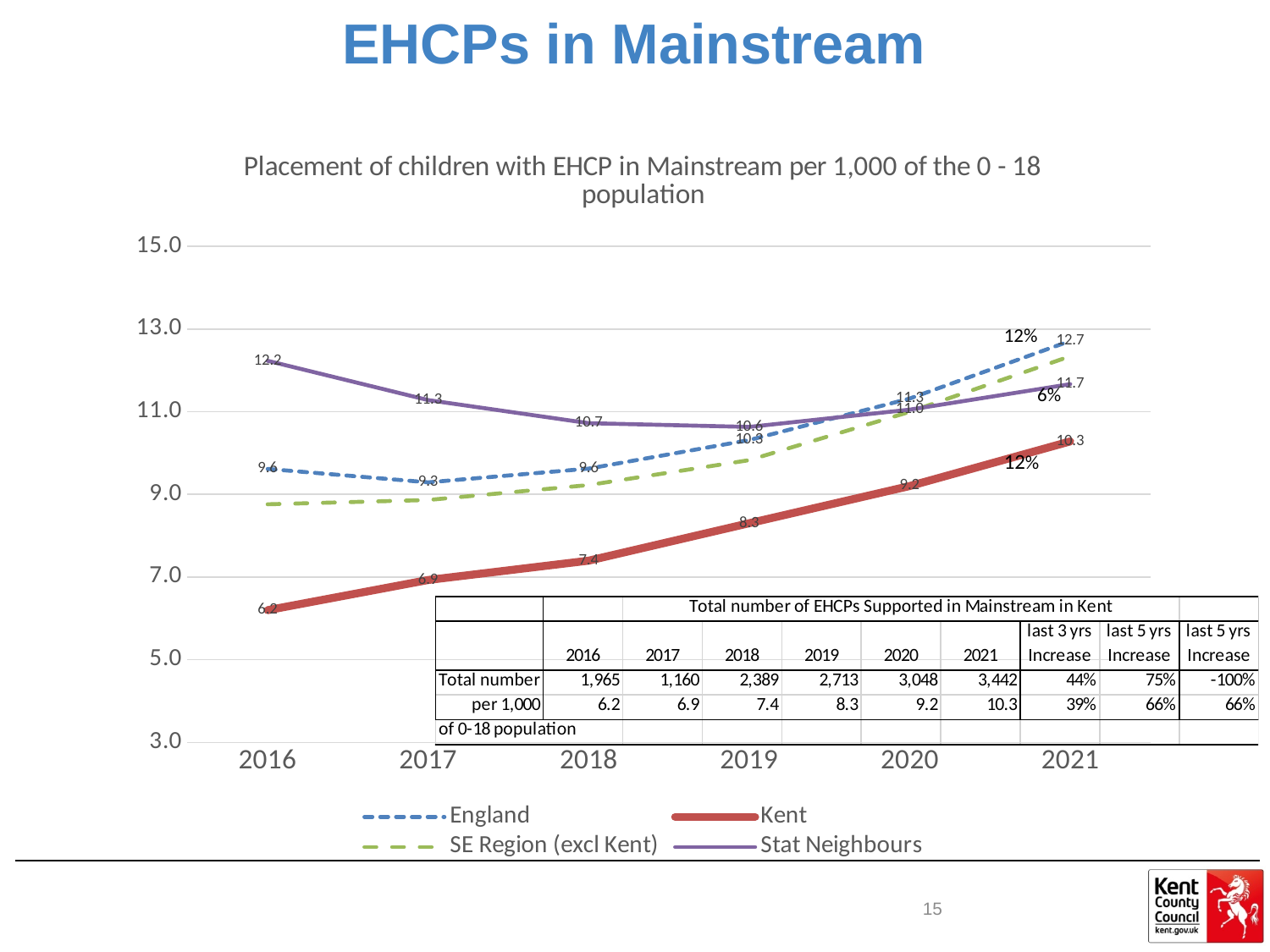
Does the Kent line rise or fall from 2016 to 2021? rises What is the Stat Neighbours value in 2016? 12.2 What kind of chart is shown on the slide? line chart In which year is the Kent value highest? 2021 How many years are plotted along the x axis of the chart? 6 Is the SE Region (excl Kent) value for 2021 greater or less than 11.0? greater How many series does the chart legend list? 4 By how much did the Kent value increase from 2016 to 2021? 4.1 In 2016, which is larger: the England value or the Kent value? England What is the Kent value per 1,000 in 2021? 10.3 In which year is the Stat Neighbours value lowest? 2019 What is the England value in 2021? 12.7